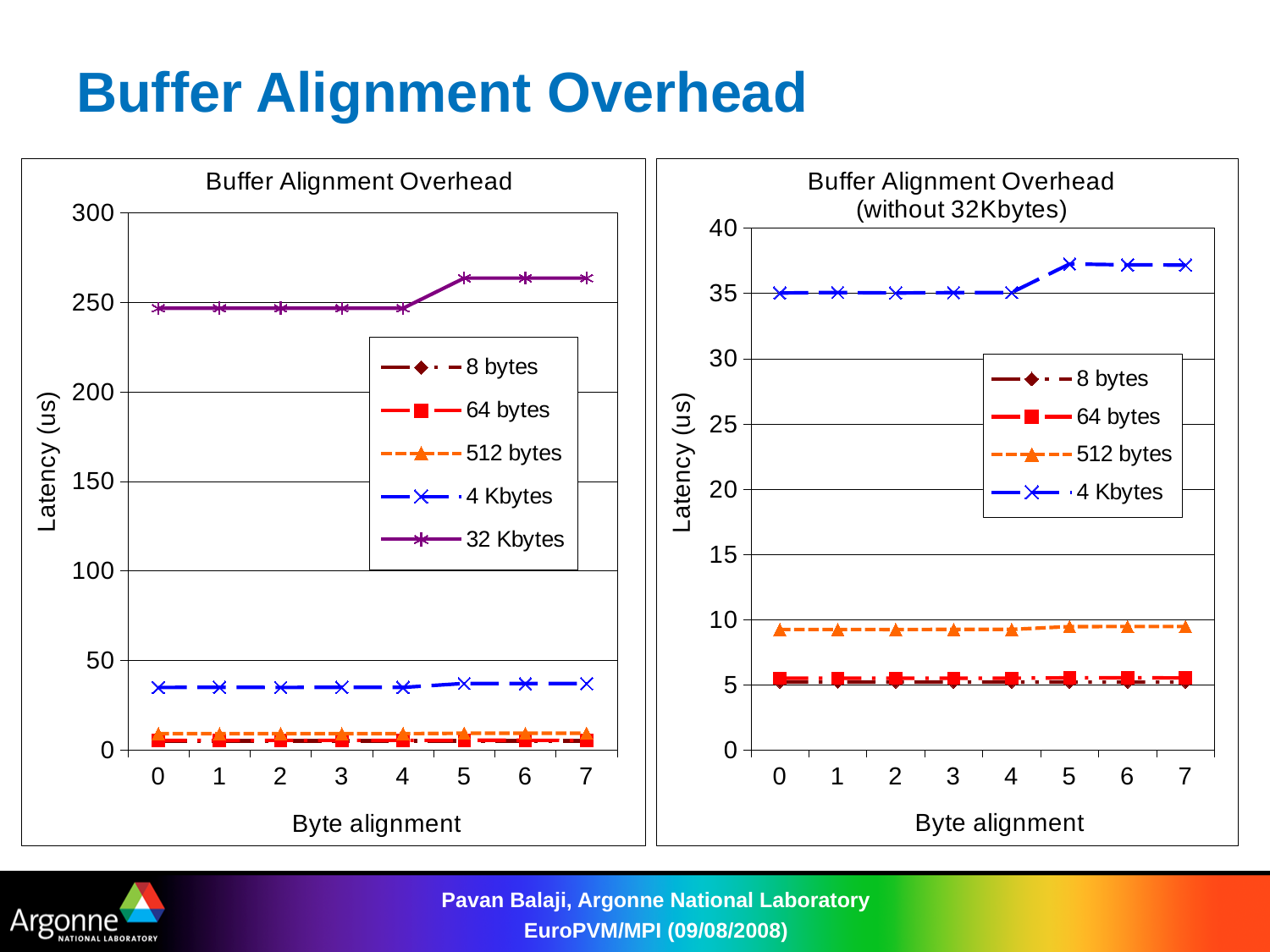
In the right chart, how many byte alignment values are plotted along the x axis? 8 In the left chart, which series has the highest latency? 32 Kbytes In the right chart, is the latency for 512 bytes at byte alignment 0 greater or less than 10? less How many series does the legend of the left chart list? 5 In the left chart, is the latency for 32 Kbytes at byte alignment 0 greater or less than 200? greater What is the y-axis label of the right chart? Latency (us) In the right chart, does the latency for 4 Kbytes rise or fall from byte alignment 0 to byte alignment 7? rises In the right chart, which series has the highest latency? 4 Kbytes What kind of chart is the left chart titled "Buffer Alignment Overhead"? line chart In the left chart, is the latency for 4 Kbytes at byte alignment 2 greater or less than 50? less In the right chart, which is larger at byte alignment 5: the latency for 512 bytes or for 64 bytes? 512 bytes How many series does the legend of the right chart (without 32Kbytes) list? 4